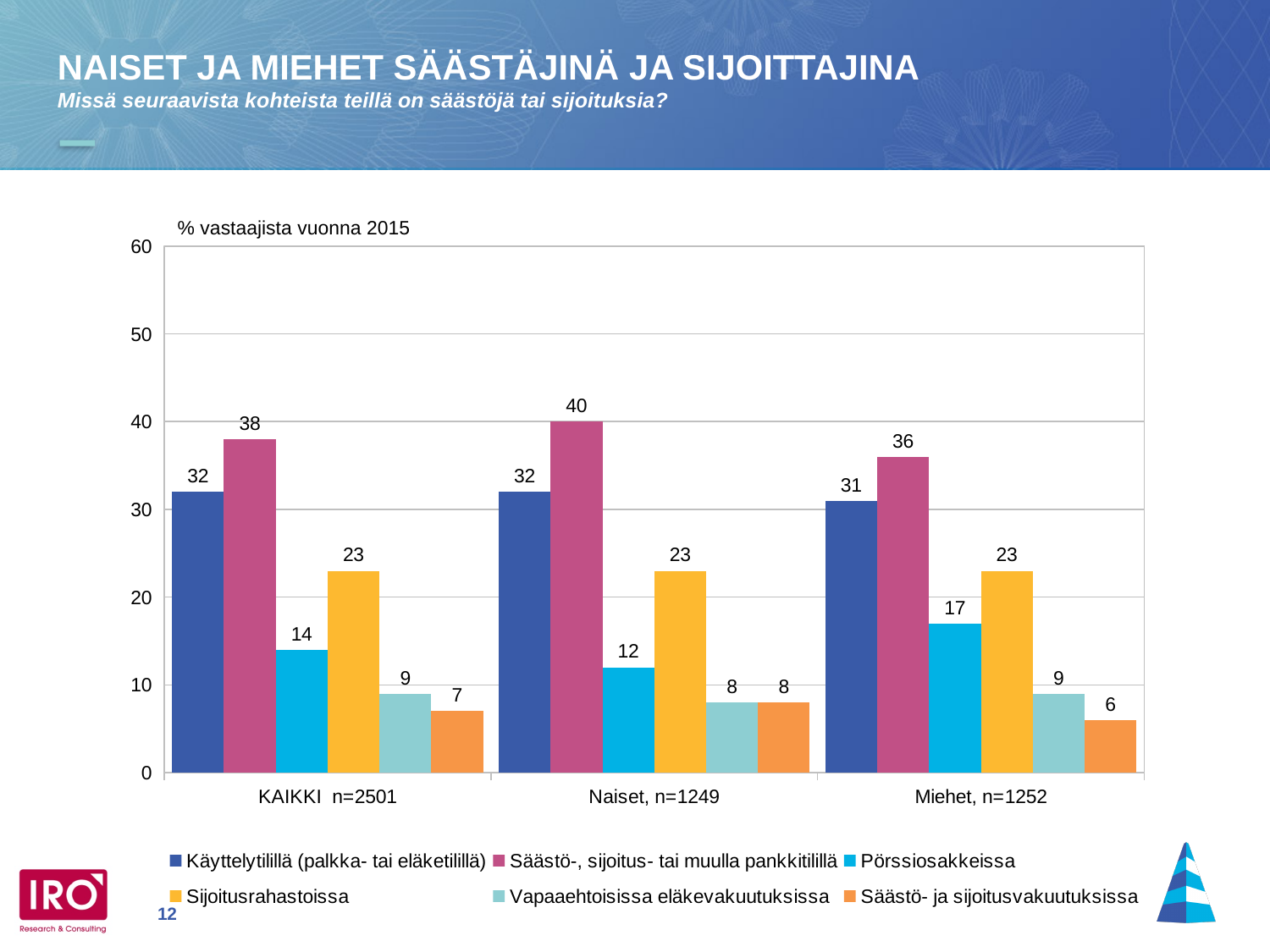
What kind of chart is shown on the slide? Bar chart Which series has the highest value in the Miehet, n=1252 group? Säästö-, sijoitus- tai muulla pankkitilillä How many groups are shown on the x axis? 3 What is the value for Pörssiosakkeissa in the Miehet, n=1252 group? 17 Which is larger: the Pörssiosakkeissa value for Naiset, n=1249 or for Miehet, n=1252? Miehet, n=1252 What is the difference between the Säästö-, sijoitus- tai muulla pankkitilillä values for Naiset, n=1249 and Miehet, n=1252? 4 What is the value for Säästö- ja sijoitusvakuutuksissa in the KAIKKI n=2501 group? 7 What is the label shown above the chart's y axis? % vastaajista vuonna 2015 What is the difference between the Pörssiosakkeissa and Sijoitusrahastoissa values in the KAIKKI n=2501 group? 9 Which series has the lowest value in the Miehet, n=1252 group? Säästö- ja sijoitusvakuutuksissa How many series does the legend list? 6 What is the value for Säästö-, sijoitus- tai muulla pankkitilillä in the Naiset, n=1249 group? 40